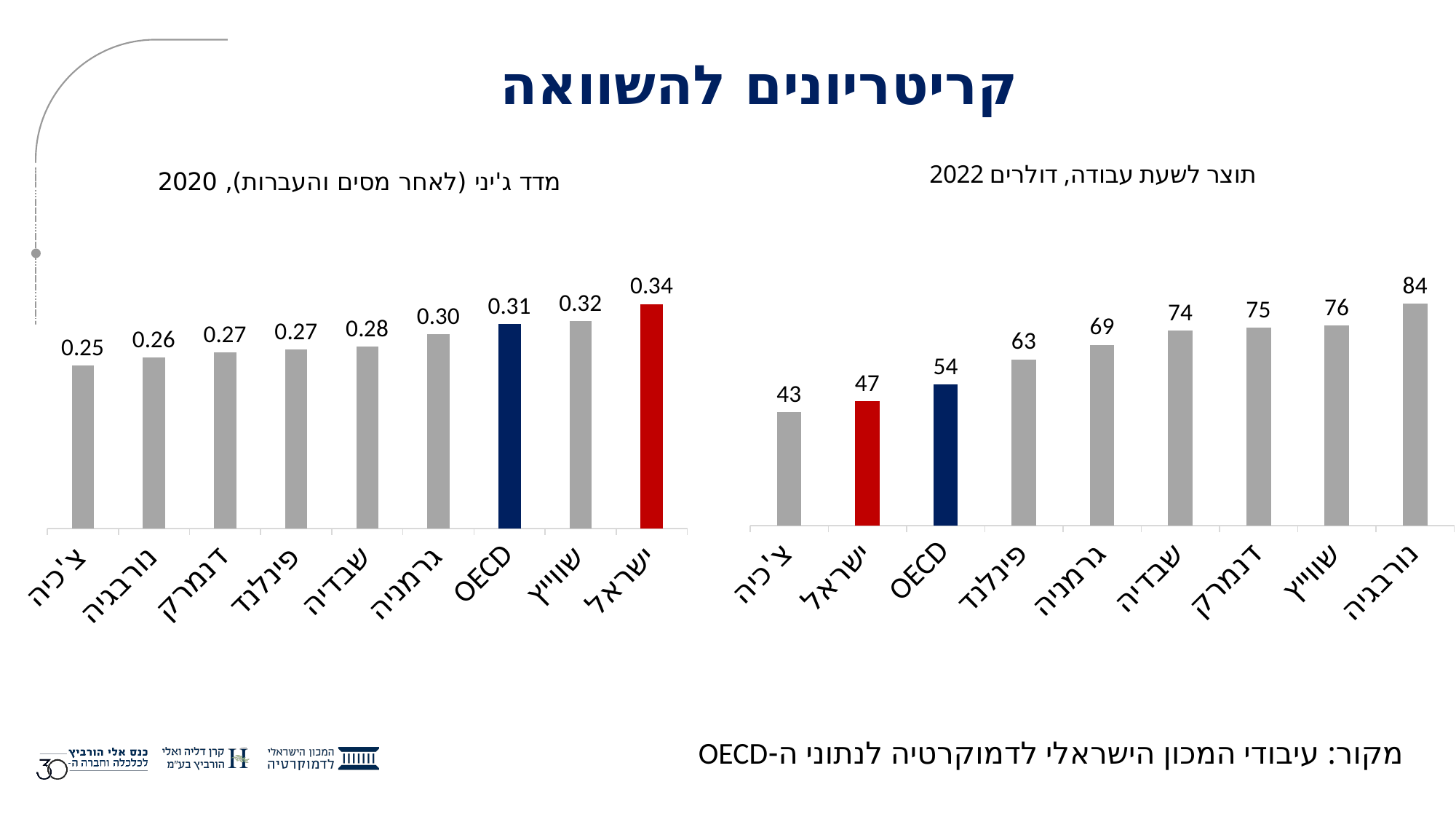
In the right-hand chart (תוצר לשעת עבודה, דולרים 2022), do the values rise or fall from left to right? Rise In the right-hand chart (תוצר לשעת עבודה, דולרים 2022), what is the value for Israel (ישראל)? 47 What colour is the bar for Israel (ישראל) in both charts? Red What type of chart is the right-hand chart (תוצר לשעת עבודה, דולרים 2022)? Bar chart In the right-hand chart (תוצר לשעת עבודה, דולרים 2022), what is the difference between Norway (נורבגיה) and Israel (ישראל)? 37 In the right-hand chart (תוצר לשעת עבודה, דולרים 2022), which is larger: the value for Germany (גרמניה) or the OECD value? גרמניה (Germany) In the left-hand chart (מדד ג'יני, 2020), what is the difference between Israel (ישראל) and the OECD value? 0.03 How many countries/categories are shown in the left-hand chart (מדד ג'יני, 2020)? 9 In the left-hand chart (מדד ג'יני, 2020), which country has the lowest value? צ'כיה (Czechia) In the left-hand chart (מדד ג'יני, 2020), what is the OECD value? 0.31 In the right-hand chart (תוצר לשעת עבודה, דולרים 2022), which country has the highest value? נורבגיה (Norway) In the left-hand chart (מדד ג'יני, 2020), what is the value for Israel (ישראל)? 0.34